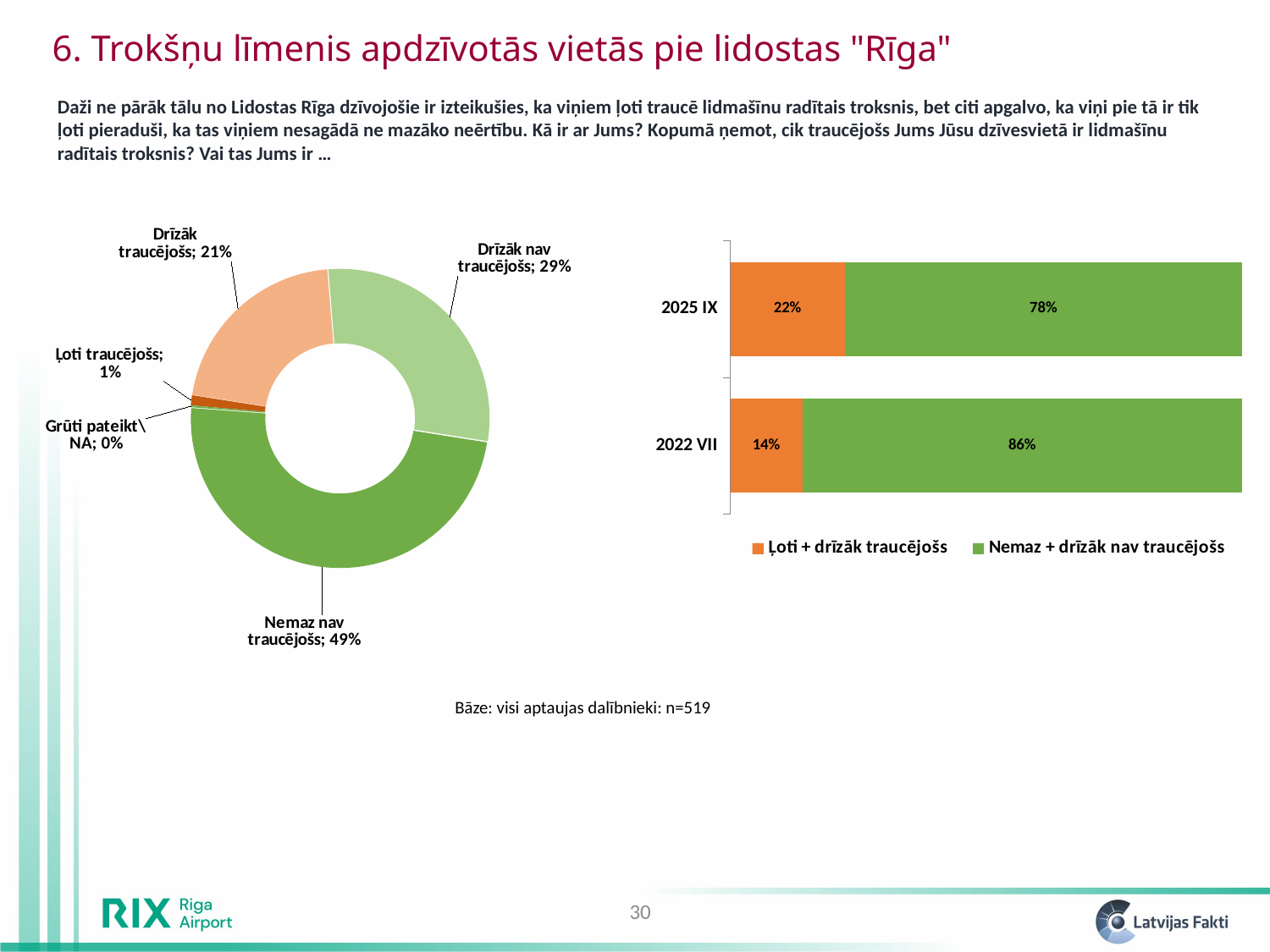
In the bar chart on the right, what is the value for "Ļoti + drīzāk traucējošs" in 2025 IX? 22% In the bar chart on the right, what is the difference between the "Nemaz + drīzāk nav traucējošs" values for 2022 VII and 2025 IX? 8% In the doughnut chart on the left, how many categories are shown? 5 What type of chart is shown on the right side of the slide? Stacked bar chart In the doughnut chart on the left, what share is labelled "Nemaz nav traucējošs"? 49% In the doughnut chart on the left, which category has the largest share? Nemaz nav traucējošs In the doughnut chart on the left, which category has the smallest share? Grūti pateikt\NA In the doughnut chart on the left, what is the difference between the shares for "Drīzāk nav traucējošs" and "Drīzāk traucējošs"? 8% In the bar chart on the right, how many series does the legend list? 2 In the bar chart on the right, which year has the larger value for "Ļoti + drīzāk traucējošs", 2025 IX or 2022 VII? 2025 IX In the bar chart on the right, what is the value for "Nemaz + drīzāk nav traucējošs" in 2022 VII? 86% In the doughnut chart on the left, what share is labelled "Drīzāk nav traucējošs"? 29%